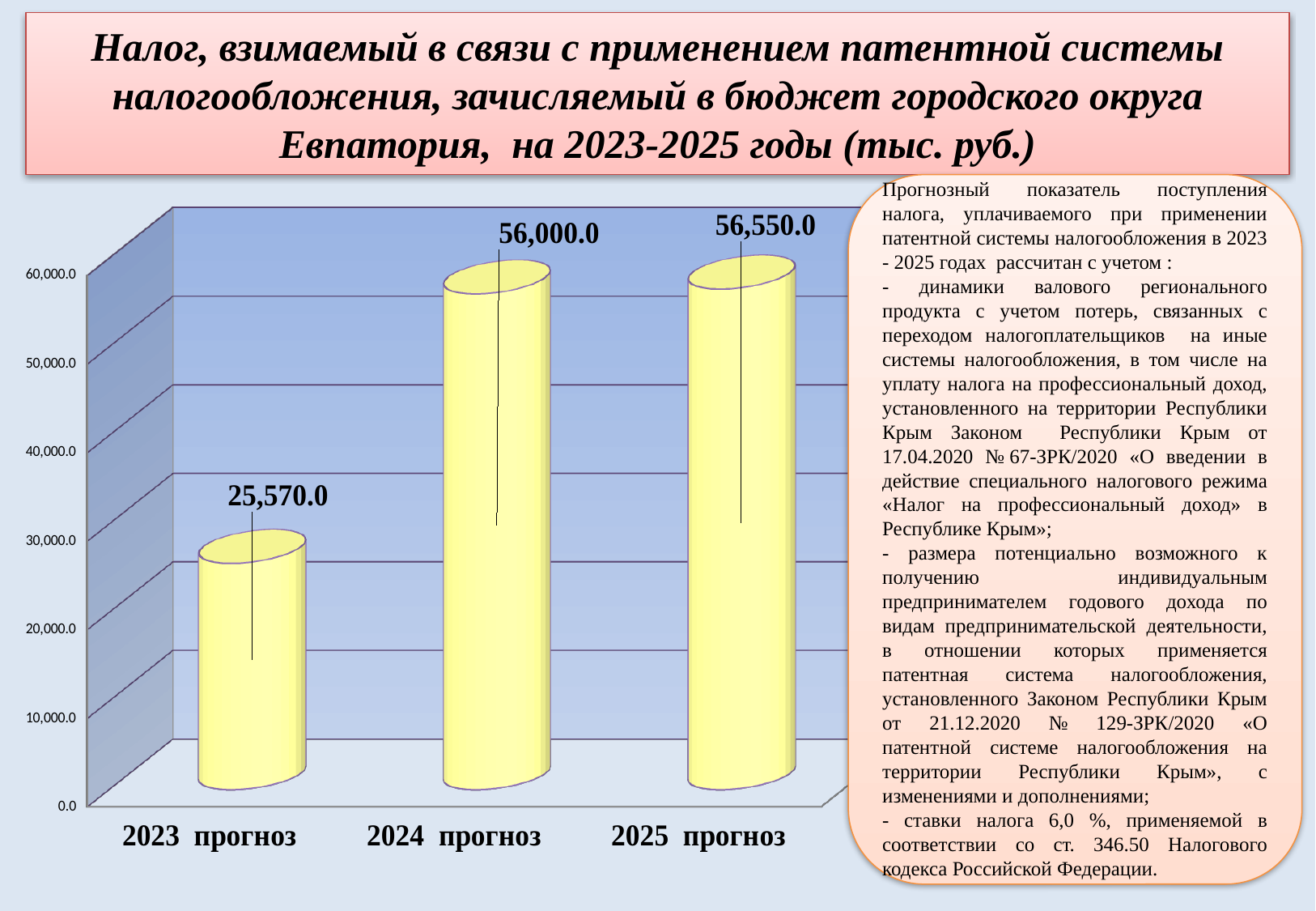
Which category has the highest value? 2025 прогноз What is the value for 2023 прогноз? 25,570.0 What kind of chart is shown on the slide? bar chart Which category has the lowest value? 2023 прогноз Is the value for 2023 прогноз greater or less than 30,000.0? less How many categories are shown on the x axis? 3 What is the value for 2024 прогноз? 56,000.0 Which is larger, the value for 2023 прогноз or the value for 2024 прогноз? 2024 прогноз What is the difference between the values for 2024 прогноз and 2023 прогноз? 30,430.0 What is the value for 2025 прогноз? 56,550.0 Do the values rise or fall from 2023 прогноз to 2025 прогноз? rise What is the difference between the values for 2025 прогноз and 2024 прогноз? 550.0